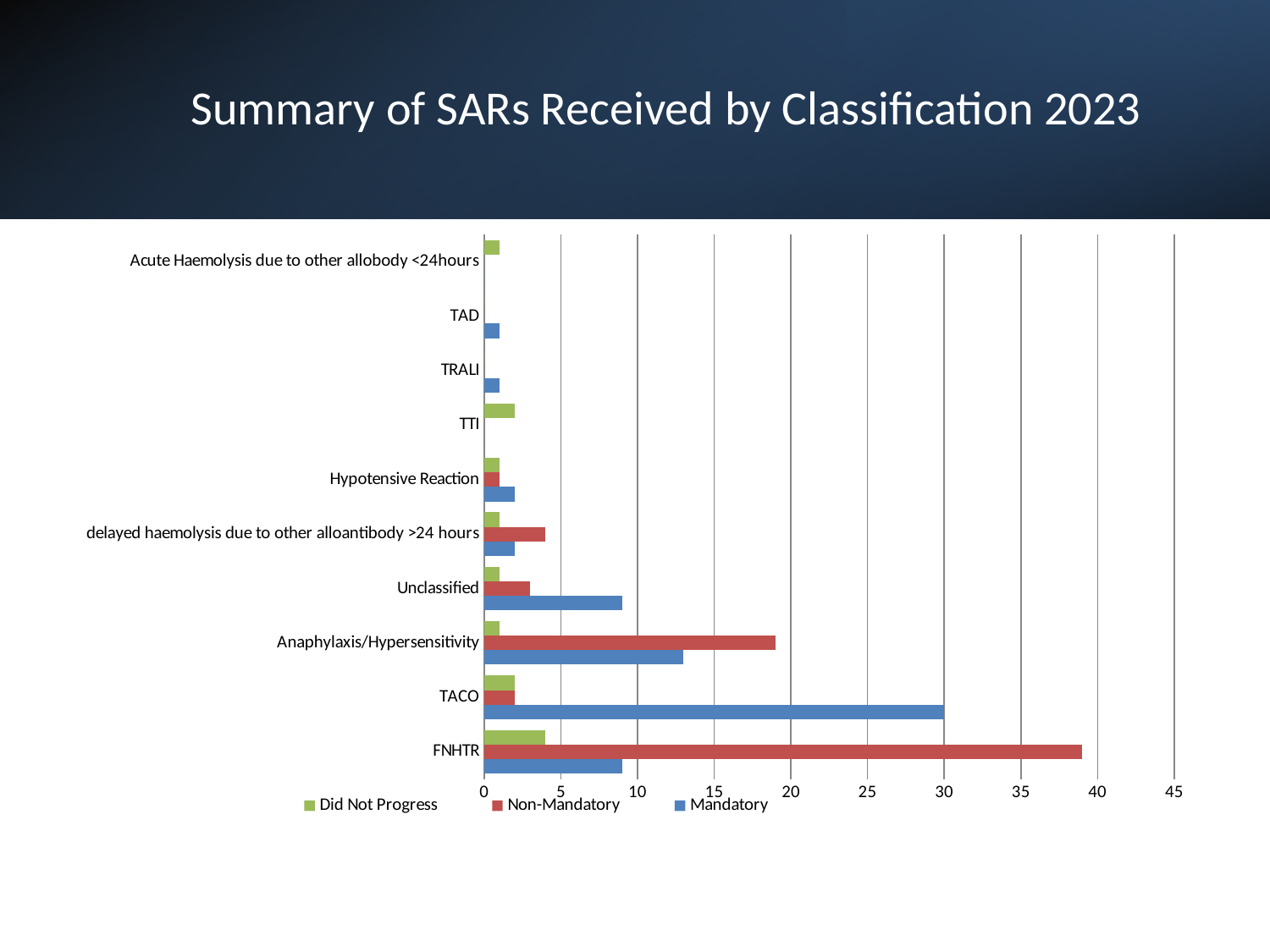
Is the Non-Mandatory value for Anaphylaxis/Hypersensitivity greater or less than 15? greater How many classification categories are shown on the chart? 10 Is the Mandatory value for TACO greater or less than 25? greater For FNHTR, which is larger: the Non-Mandatory value or the Mandatory value? Non-Mandatory What kind of chart is shown on the slide? bar chart Which classification has the highest Mandatory value? TACO How many series does the legend list? 3 Which series is shown in green in the legend? Did Not Progress Is the Mandatory value for Unclassified greater or less than 10? less What is the title of the chart? Summary of SARs Received by Classification 2023 Which classification has the highest Non-Mandatory value? FNHTR